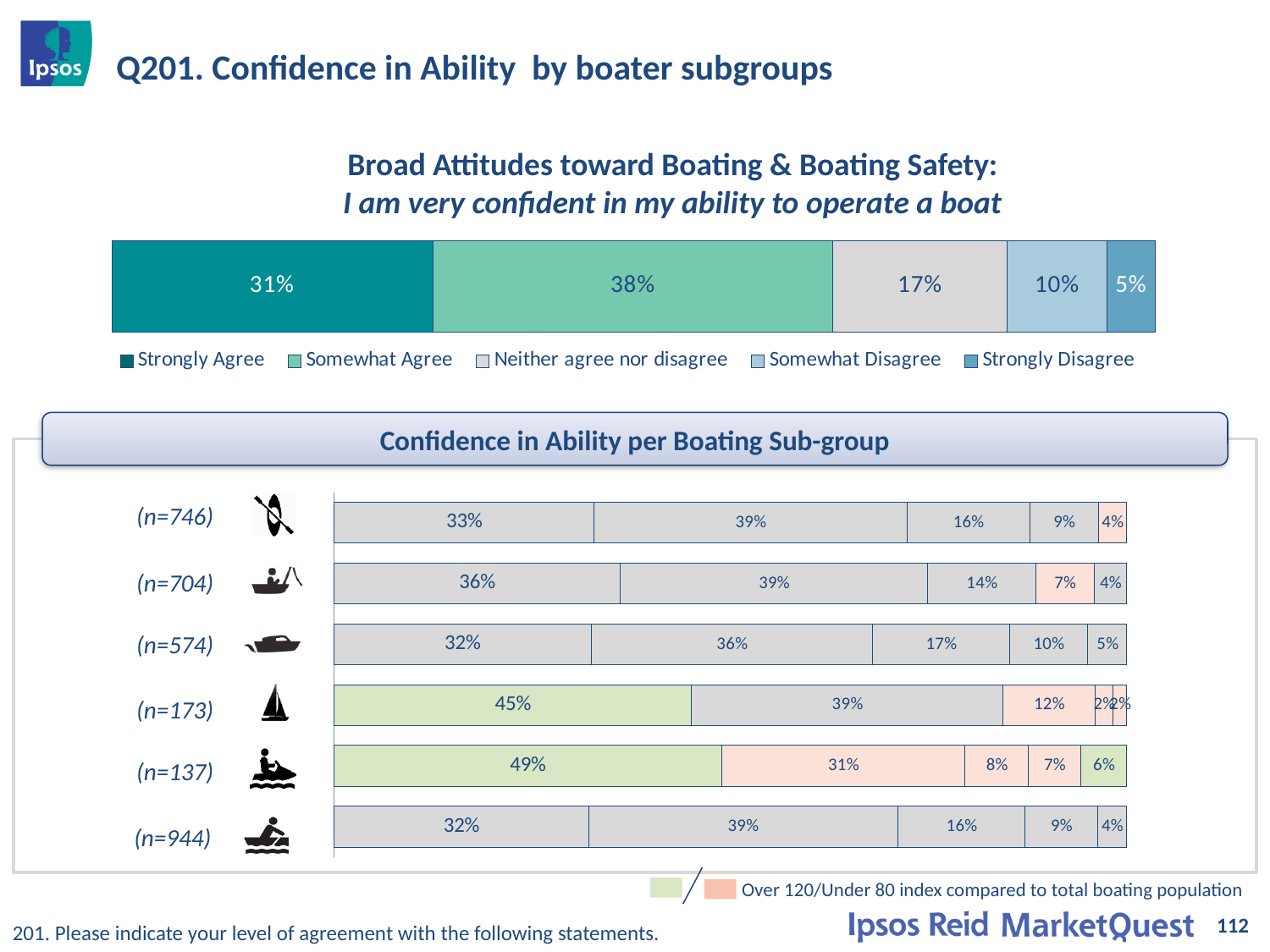
In the bottom chart, what is the difference between the leftmost segment values for the subgroups with n=704 and n=746? 3% In the top chart, which response category has the largest share? Somewhat Agree What type of chart is the top chart? Stacked bar chart In the bottom chart, what is the value of the leftmost segment for the subgroup with n=137? 49% In the top chart, what is the difference between the Somewhat Agree and Strongly Agree percentages? 7% How many response categories does the legend of the top chart list? 5 In the top chart (Broad Attitudes toward Boating & Boating Safety), what percentage of respondents Strongly Agree? 31% In the top chart, what percentage of respondents Somewhat Disagree? 10% In the top chart, which response category has the smallest share? Strongly Disagree In the bottom chart, is the leftmost segment larger for the subgroup with n=173 or the subgroup with n=574? n=173 In the bottom chart, which subgroup has the highest value in its leftmost segment? n=137 In the bottom chart (Confidence in Ability per Boating Sub-group), how many boater subgroups are shown? 6